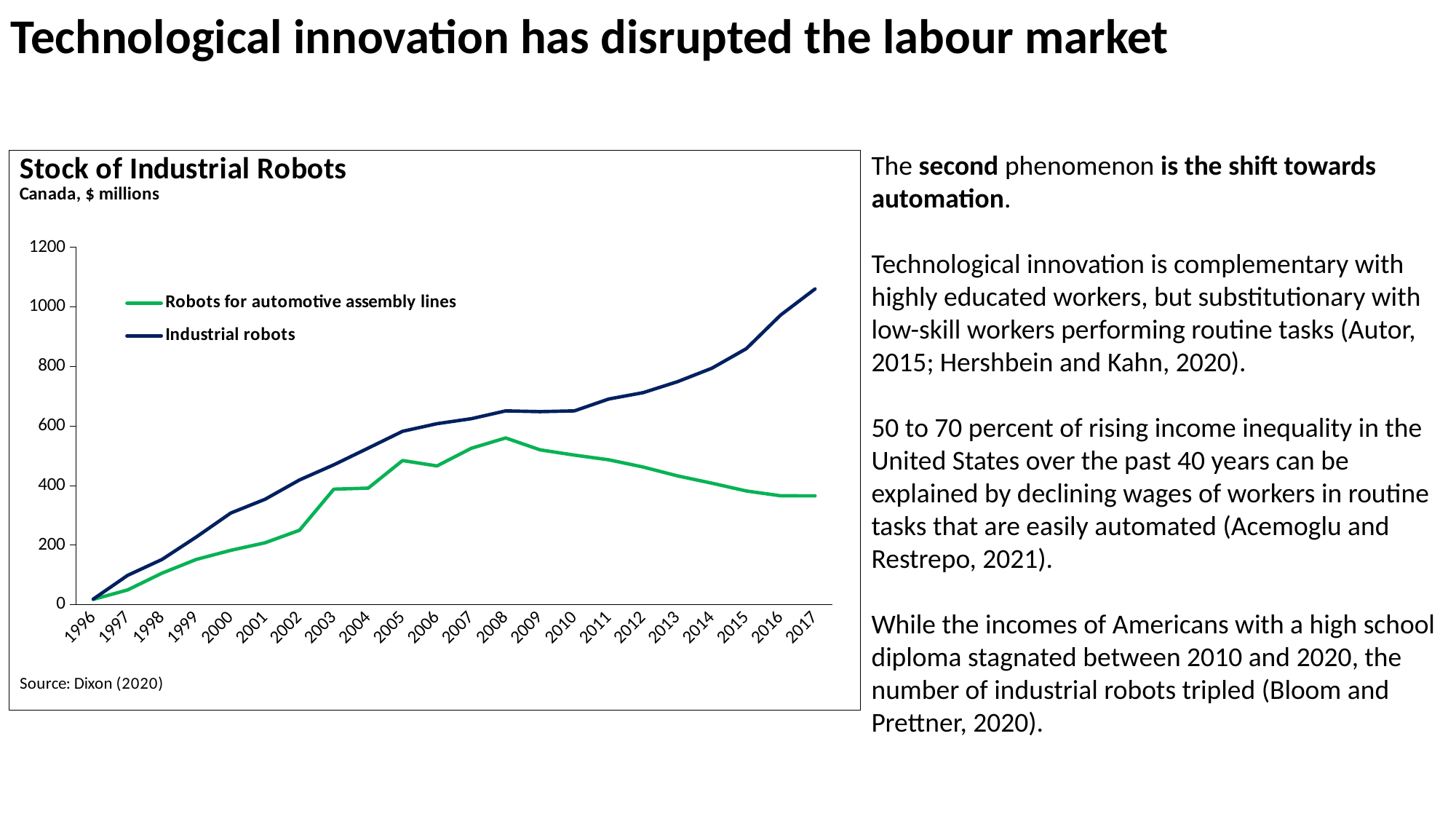
What kind of chart is shown on the slide? line chart How many years are shown on the x axis of the chart? 22 Is the value for Industrial robots in 2017 greater or less than 1000? greater What is the source cited for the chart? Dixon (2020) Between 2008 and 2017, does the Robots for automotive assembly lines line rise or fall? fall How many series does the legend of the Stock of Industrial Robots chart list? 2 In which year does the Robots for automotive assembly lines series reach its highest value? 2008 Is the value for Robots for automotive assembly lines in 2017 greater or less than 400? less Is the value for Industrial robots in 2005 greater or less than 400? greater In which year is the Industrial robots series at its lowest value? 1996 Does the Industrial robots line rise or fall from 1996 to 2017? rise In 2017, which series has the higher value: Industrial robots or Robots for automotive assembly lines? Industrial robots